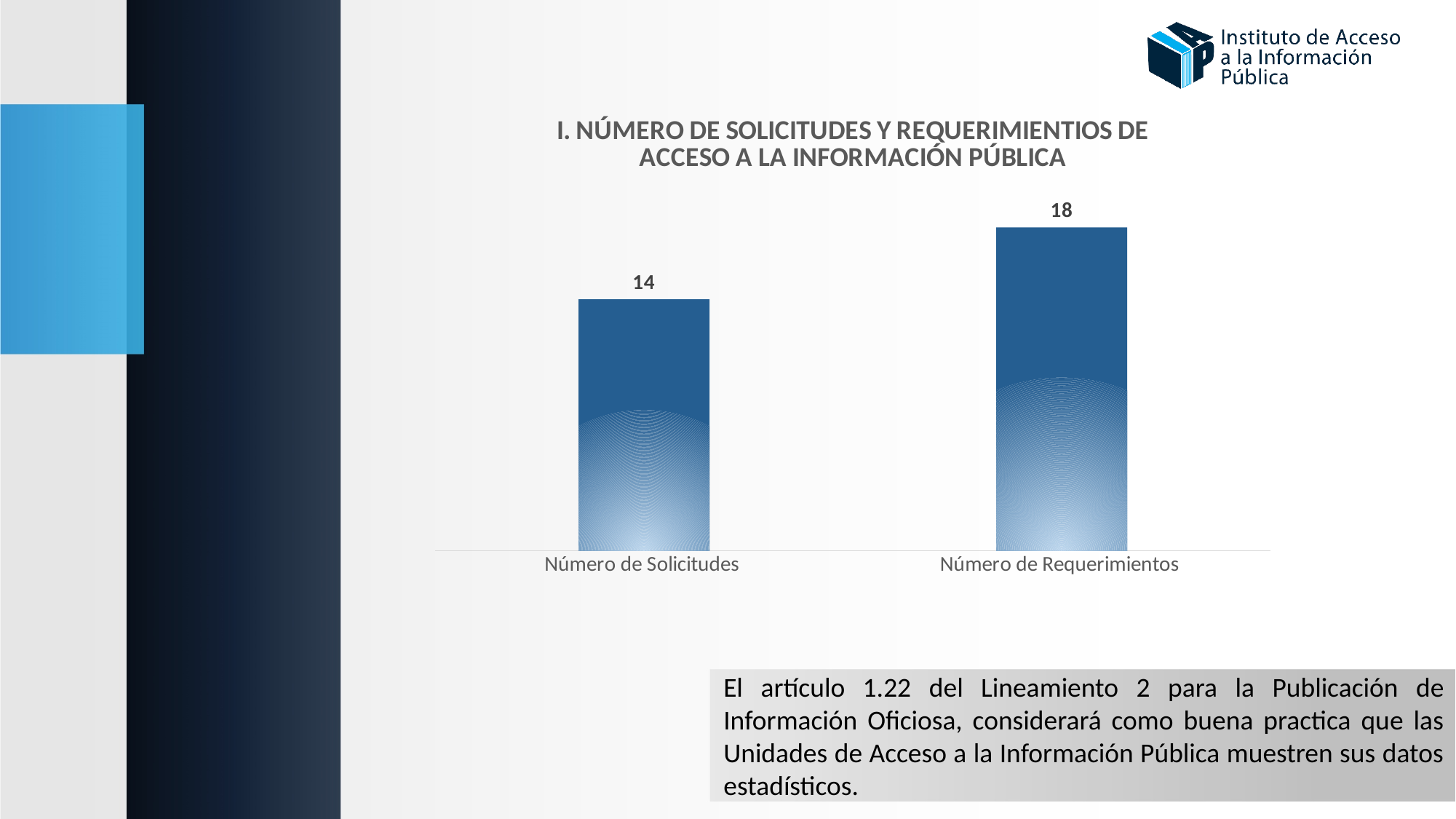
Which is larger, Número de Solicitudes or Número de Requerimientos? Número de Requerimientos Do the values rise or fall from left to right across the categories? Rise Which category has the lowest value? Número de Solicitudes What is the value for Número de Requerimientos? 18 How many categories are shown in the chart? 2 What is the value for Número de Solicitudes? 14 What is the title of the chart? I. NÚMERO DE SOLICITUDES Y REQUERIMIENTIOS DE ACCESO A LA INFORMACIÓN PÚBLICA What kind of chart is shown on the slide? Bar chart What is the difference between Número de Requerimientos and Número de Solicitudes? 4 What colour are the bars in the chart? Blue Which category has the highest value? Número de Requerimientos